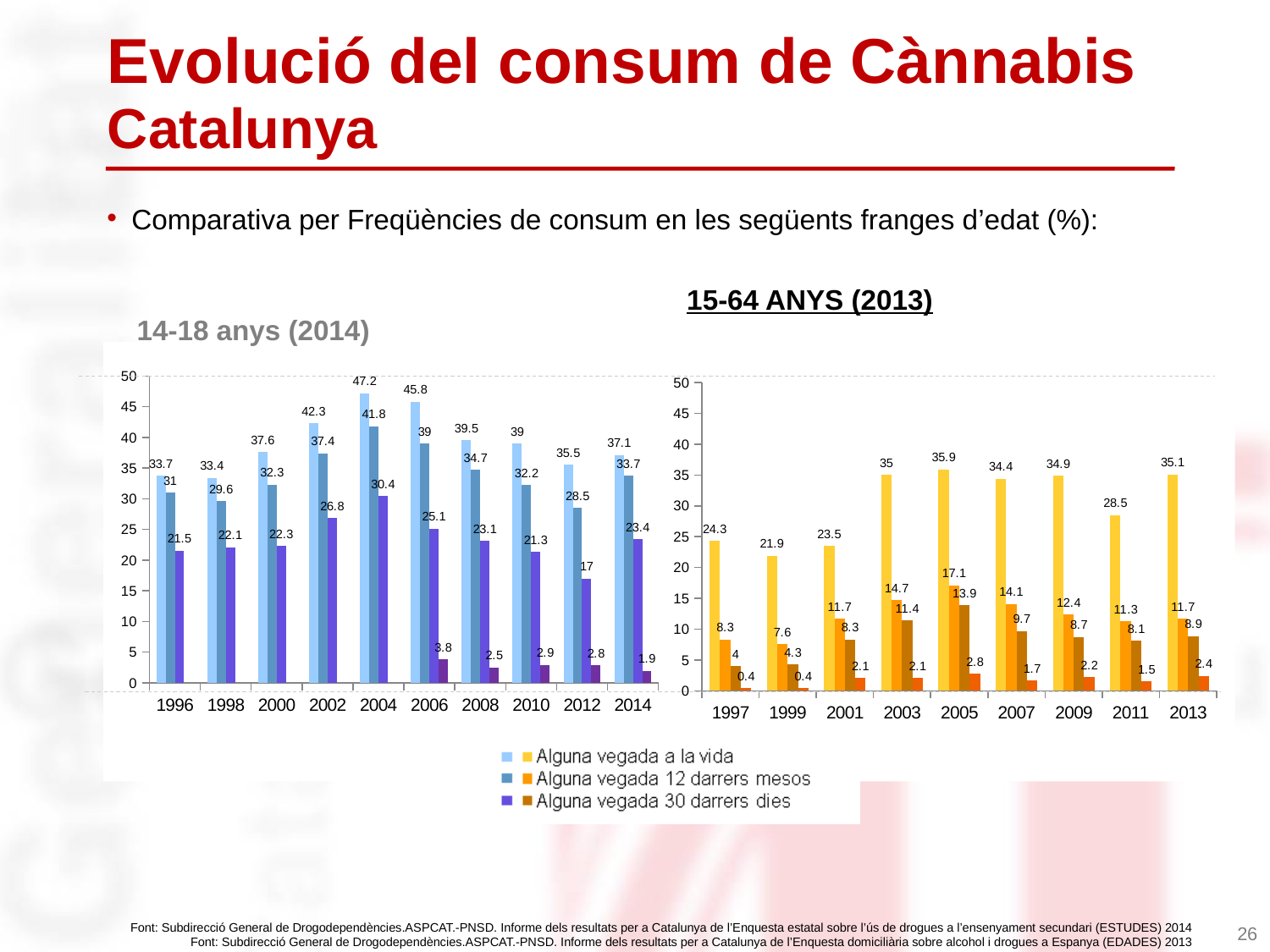
In the 15-64 ANYS (2013) chart, which is larger, the 'Alguna vegada a la vida' value for 2003 or for 2011? 2003 In the 14-18 anys (2014) chart, which year has the highest value for 'Alguna vegada a la vida'? 2004 In the 15-64 ANYS (2013) chart, which year has the highest value for 'Alguna vegada 12 darrers mesos'? 2005 In the 14-18 anys (2014) chart, what is the value for 'Alguna vegada 12 darrers mesos' in 2014? 33.7 In the 14-18 anys (2014) chart, what is the value for 'Alguna vegada a la vida' in 2004? 47.2 In the 14-18 anys (2014) chart, what is the value for 'Alguna vegada 30 darrers dies' in 2012? 17 How many series does the legend list? 3 In the 15-64 ANYS (2013) chart, what is the value for 'Alguna vegada a la vida' in 2013? 35.1 In the 14-18 anys (2014) chart, what is the difference between the 'Alguna vegada a la vida' values for 2004 and 2014? 10.1 How many years are shown on the x axis of the 14-18 anys (2014) chart? 10 In the 15-64 ANYS (2013) chart, which year has the lowest value for 'Alguna vegada a la vida'? 1999 In the 15-64 ANYS (2013) chart, what is the difference between the 'Alguna vegada 12 darrers mesos' values for 2005 and 2013? 5.4